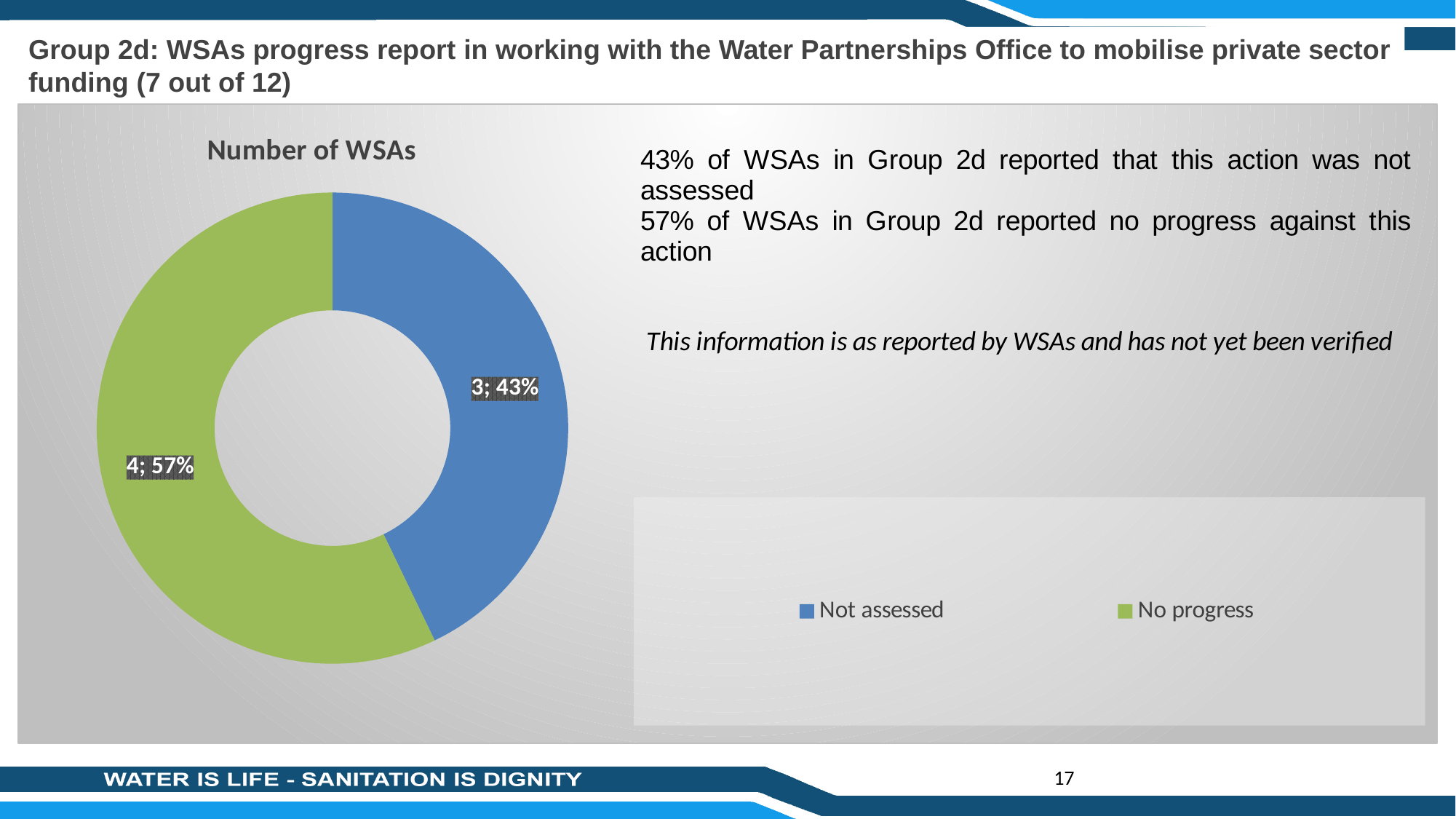
What is the title of the chart? Number of WSAs How many WSAs are in the 'Not assessed' category? 3 What share of the chart does the 'Not assessed' slice represent? 43% How many WSAs are in the 'No progress' category? 4 What share of the chart does the 'No progress' slice represent? 57% Which category has the largest slice? No progress What colour is the 'Not assessed' slice? Blue How many categories does the chart show? 2 Which category has the smallest slice? Not assessed Which is larger, the 'Not assessed' slice or the 'No progress' slice? No progress What is the difference in the number of WSAs between 'No progress' and 'Not assessed'? 1 What kind of chart is shown on the slide? Doughnut (pie) chart